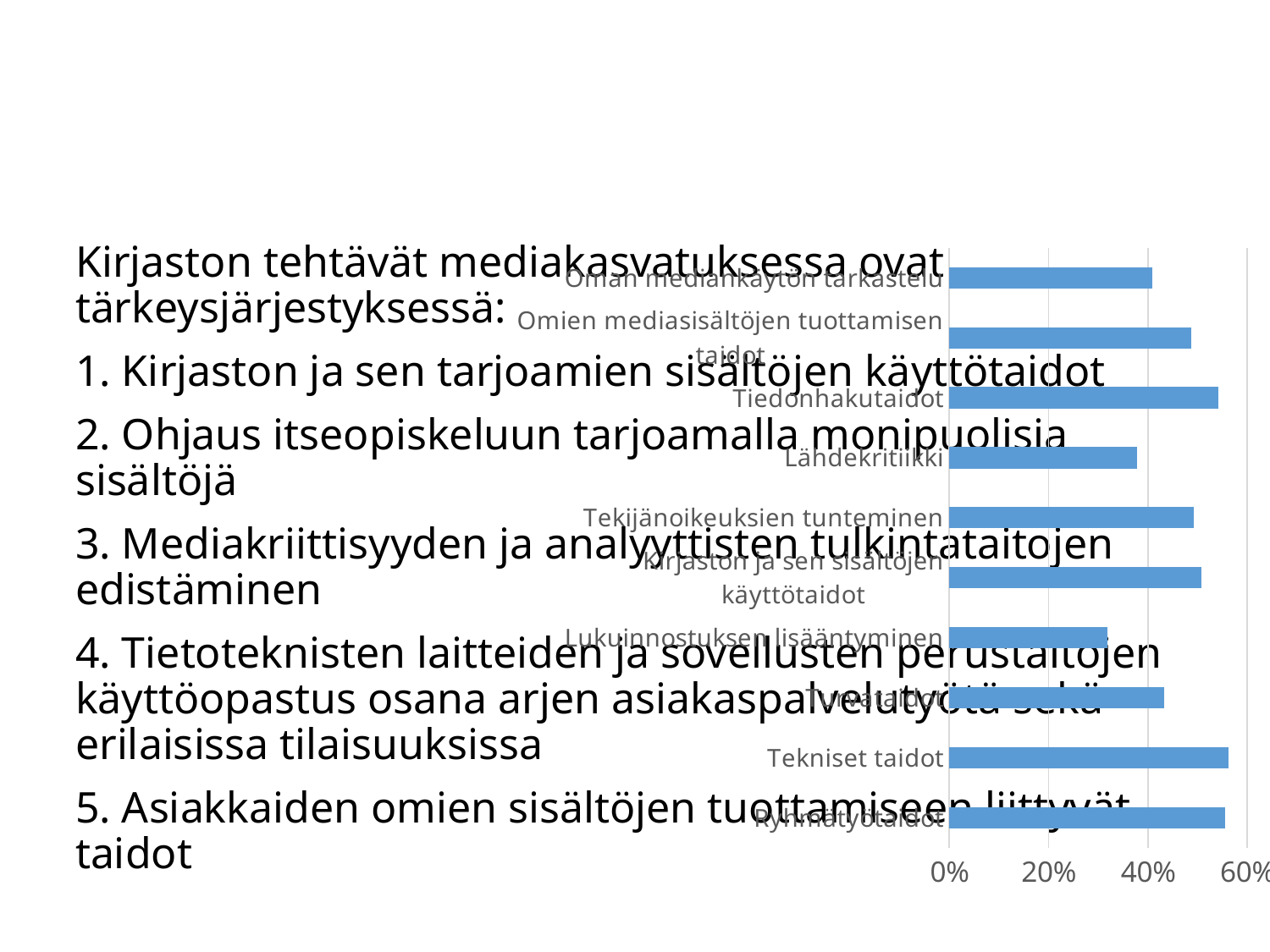
Which is larger, the value for Tiedonhakutaidot or the value for Lähdekritiikki? Tiedonhakutaidot Is the value for Lähdekritiikki greater or less than 40%? less Is the value for Lukuinnostuksen lisääntyminen greater or less than 20%? greater What kind of chart is shown on the slide? bar chart Which is larger, the value for Tekijänoikeuksien tunteminen or the value for Lähdekritiikki? Tekijänoikeuksien tunteminen Which category has the lowest value in the bar chart? Lukuinnostuksen lisääntyminen Is the value for Omien mediasisältöjen tuottamisen taidot greater or less than 40%? greater Which is larger, the value for Lukuinnostuksen lisääntyminen or the value for Tekniset taidot? Tekniset taidot What is the highest value shown on the horizontal axis of the chart? 60% How many categories does the bar chart show? 10